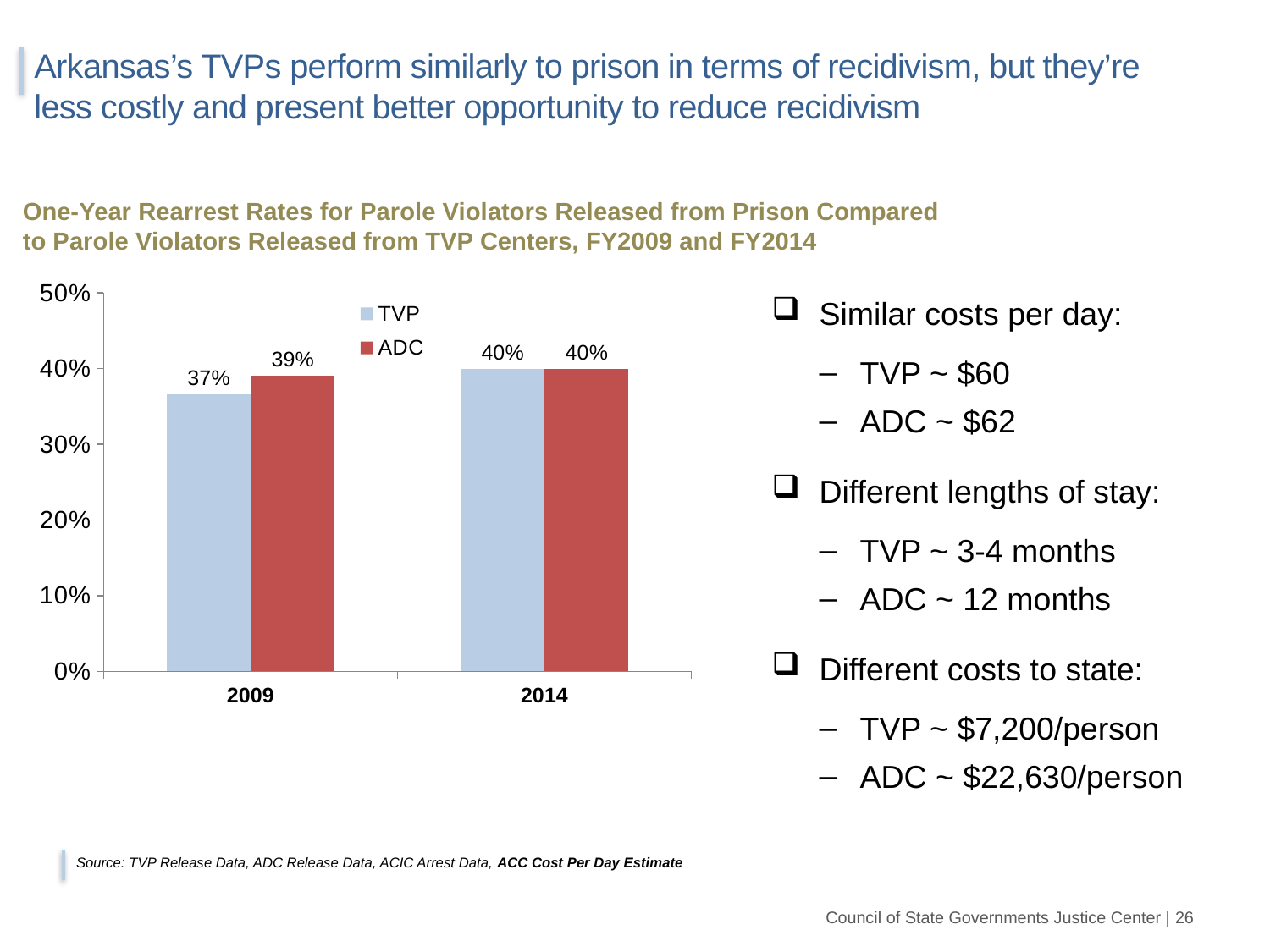
In 2009, which has the higher rearrest rate, TVP or ADC? ADC What is the one-year rearrest rate for TVP in 2014? 40% What is the one-year rearrest rate for ADC in 2014? 40% What kind of chart is shown on the slide? Bar chart Does the TVP rearrest rate rise or fall from 2009 to 2014? Rise How many years are shown on the x axis of the chart? 2 Which series has the lowest rearrest rate shown on the chart, and in which year? TVP in 2009 What is the one-year rearrest rate for ADC in 2009? 39% What is the difference between the ADC and TVP rearrest rates in 2009? 2% Is the TVP rearrest rate in 2009 greater or less than 40%? less How many series does the chart legend list? 2 What is the one-year rearrest rate for TVP in 2009? 37%